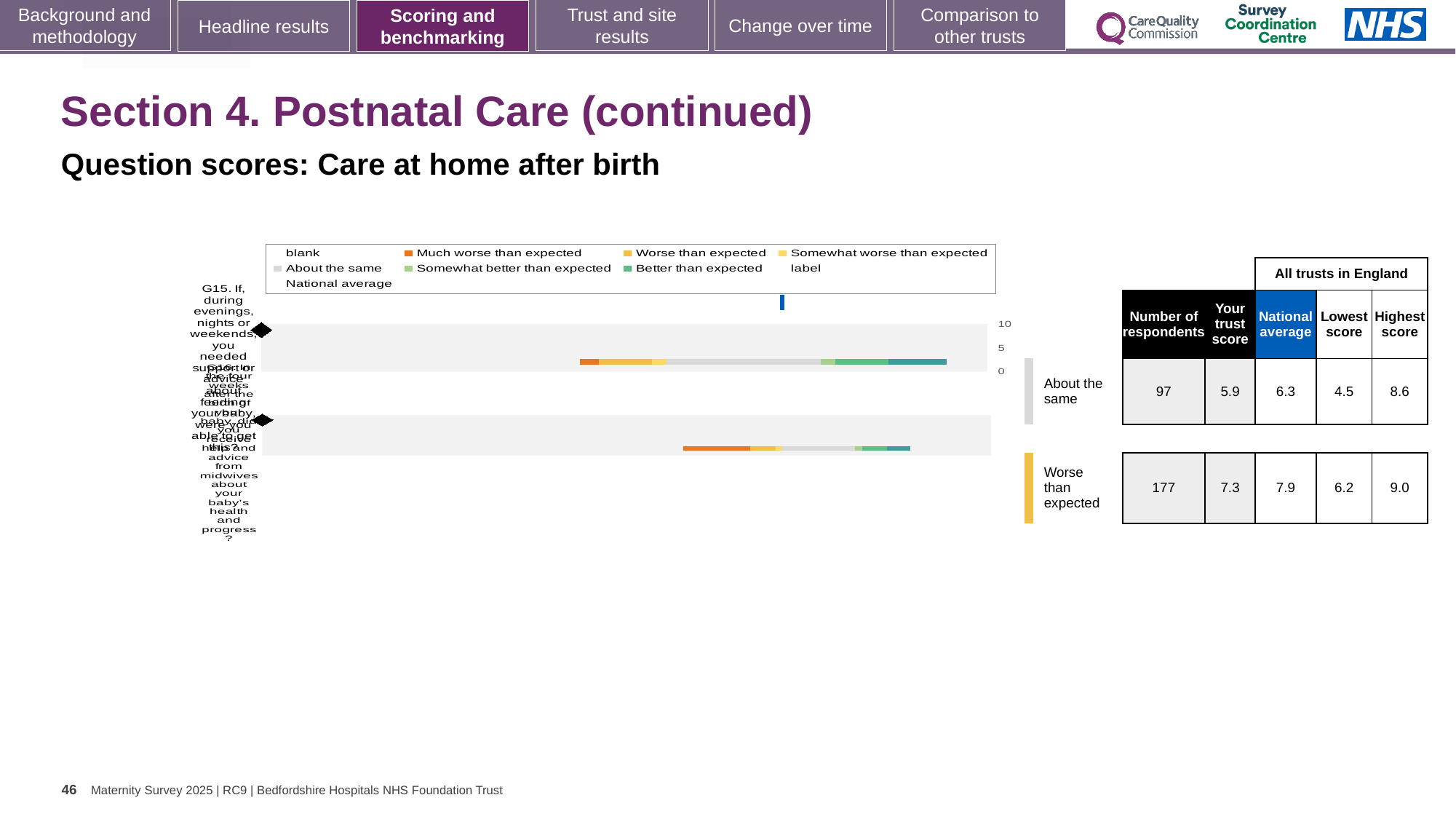
What is the difference between the highest and lowest scores for question G15? 4.1 What kind of chart is shown on the slide? bar chart What is the difference between the national average and the trust score for question G16? 0.6 What benchmark category is shown for question G15? About the same How many questions (bars) are plotted in the chart? 2 What is the national average for question G15? 6.3 What benchmark category is shown for question G16? Worse than expected What is the lowest score among all trusts in England for question G15? 4.5 What is the highest score among all trusts in England for question G16? 9.0 How many respondents answered question G16? 177 What is the trust score for question G15? 5.9 Which question has the higher trust score, G15 or G16? G16